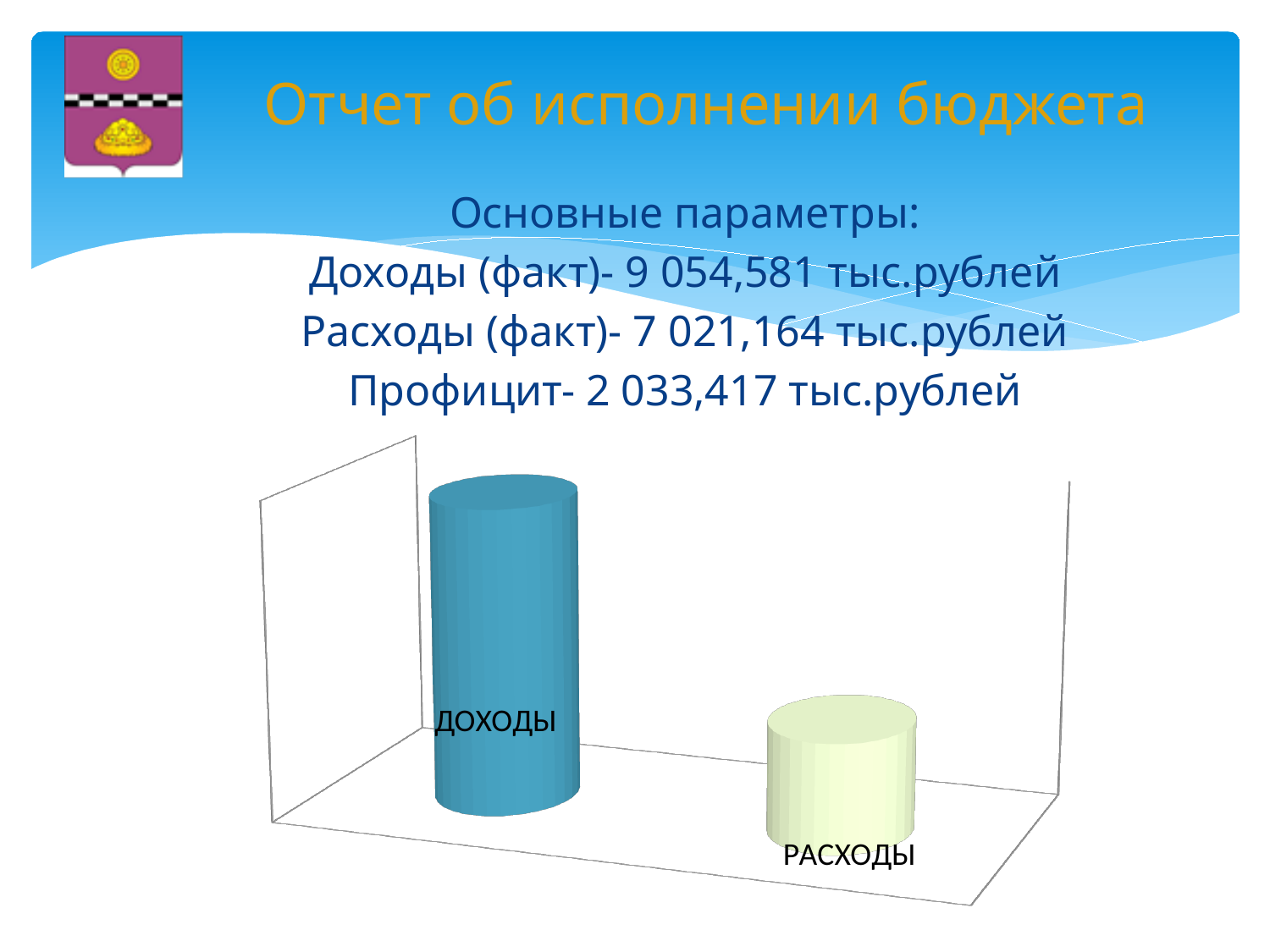
Which category has the tallest bar in the chart? ДОХОДЫ What is the difference between Доходы and Расходы as stated on the slide (the Профицит)? 2 033,417 тыс.рублей What kind of chart is shown on the slide? bar chart According to the slide, what is the actual value of Расходы (expenses)? 7 021,164 тыс.рублей According to the slide, what is the actual value of Доходы (income)? 9 054,581 тыс.рублей What is the title of the slide containing the chart? Отчет об исполнении бюджета Which is larger in the chart, ДОХОДЫ or РАСХОДЫ? ДОХОДЫ What colour is the ДОХОДЫ bar in the chart? blue Which category has the shortest bar in the chart? РАСХОДЫ How many categories are plotted in the chart? 2